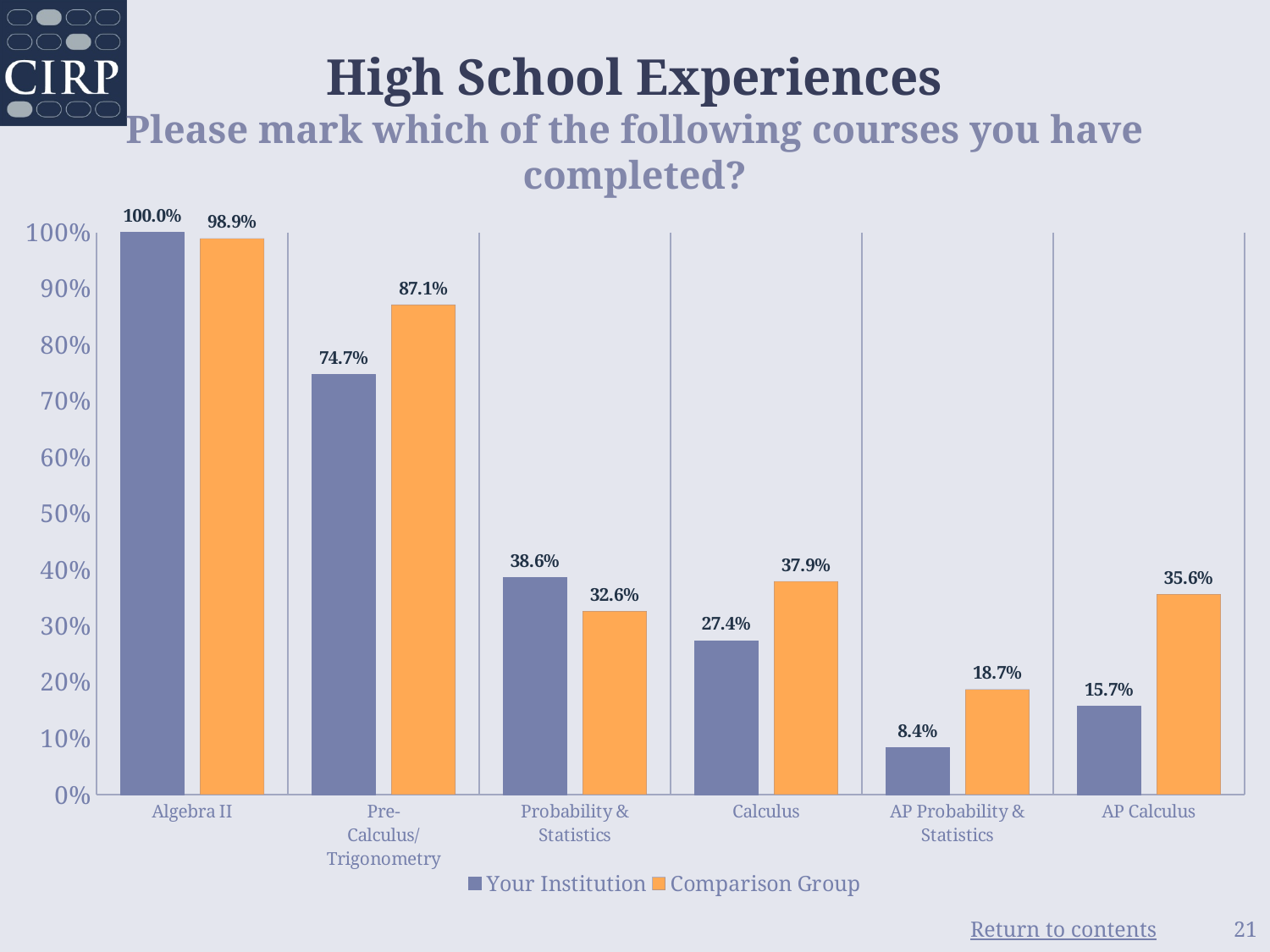
What is the difference between Your Institution and Comparison Group for Probability & Statistics? 6.0% How many courses are shown on the x axis? 6 What is the value for Comparison Group for Pre-Calculus/Trigonometry? 87.1% Which course has the highest value for Your Institution? Algebra II What colour are the Comparison Group bars? Orange What is the value for Your Institution for AP Probability & Statistics? 8.4% Which course has the lowest value for Comparison Group? AP Probability & Statistics How many series does the legend list? 2 For Calculus, which is larger: Your Institution or Comparison Group? Comparison Group What kind of chart is shown on the slide? Bar chart What is the difference between Comparison Group and Your Institution for AP Calculus? 19.9% What is the value for Your Institution for Algebra II? 100.0%